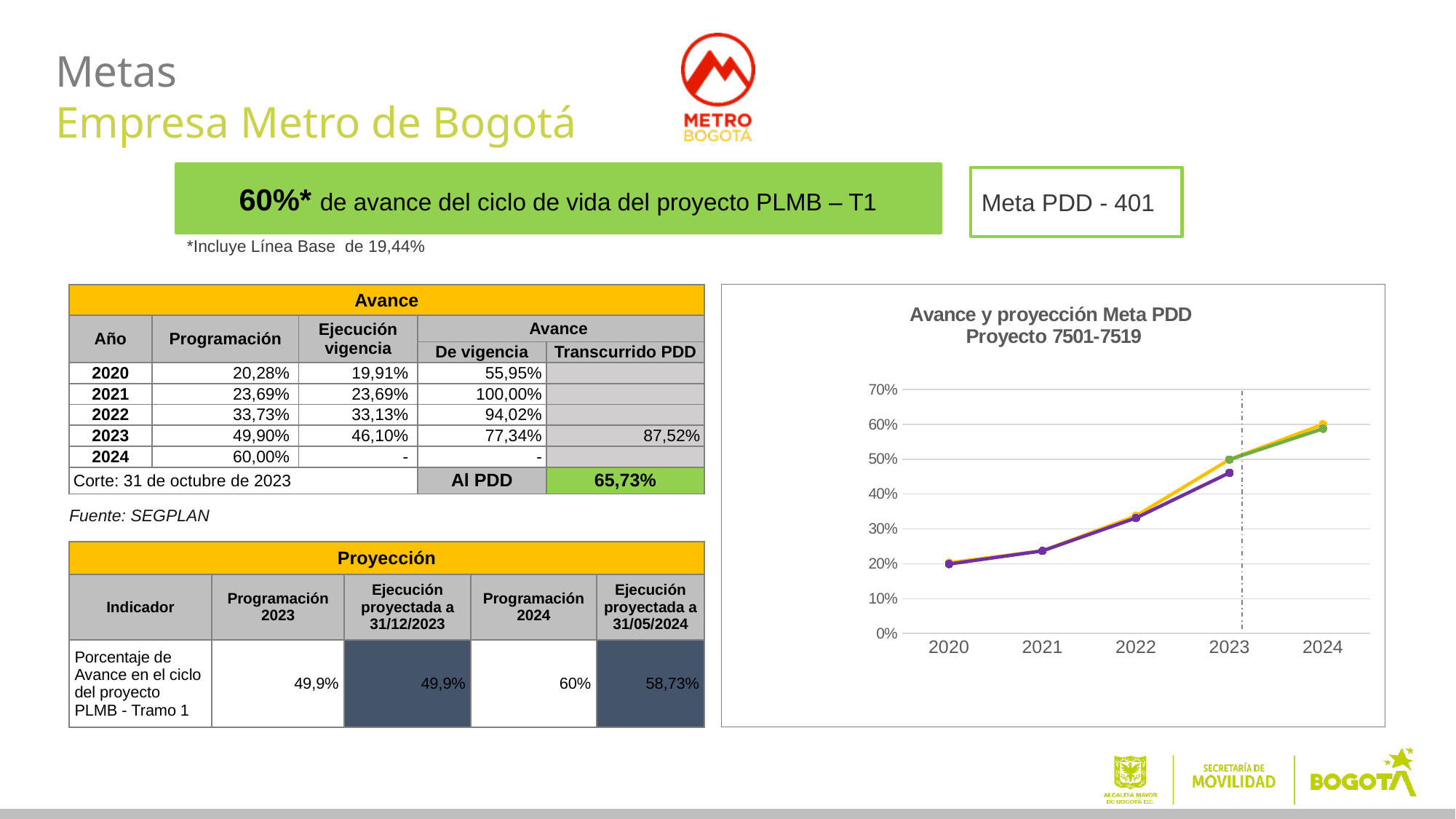
Is the value of the orange line for 2022 greater or less than 40%? less Do the values in the chart rise or fall from 2020 to 2024? rise How many years are shown on the x axis of the chart? 5 Is the value of the orange line for 2020 greater or less than 30%? less What is the highest value shown on the y axis of the chart? 70% In which year does the orange line reach its highest value? 2024 What is the title of the chart? Avance y proyección Meta PDD Proyecto 7501-7519 Is the value of the purple line for 2023 greater or less than 50%? less What kind of chart is shown on the slide? line chart In which year does the orange line have its lowest value? 2020